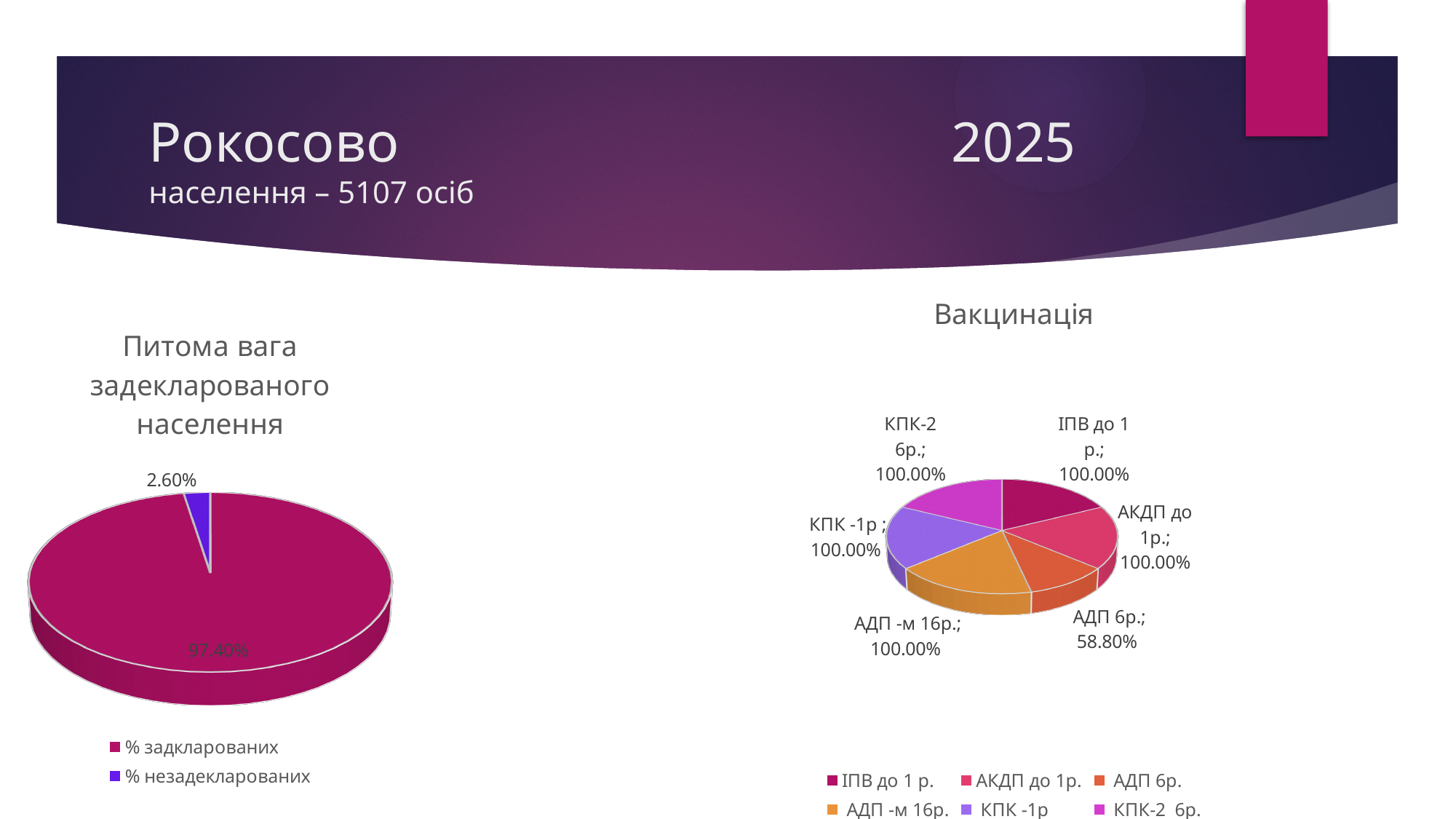
On the left chart 'Питома вага задекларованого населення', how many series does the legend list? 2 On the left chart 'Питома вага задекларованого населення', what is the difference between the two slices? 94.80% On the 'Вакцинація' chart, which category has the lowest value? АДП 6р. On the left chart 'Питома вага задекларованого населення', which category has the larger share? % задклaрованих On the 'Вакцинація' chart, what is the difference between the values for 'ІПВ до 1 р.' and 'АДП 6р.'? 41.20% On the 'Вакцинація' chart, which is larger: the value for 'АДП -м 16р.' or the value for 'АДП 6р.'? АДП -м 16р. What kind of chart is the 'Вакцинація' chart? Pie chart On the left chart 'Питома вага задекларованого населення', what is the value for '% незадекларованих'? 2.60% On the 'Вакцинація' chart, what is the value for 'АДП 6р.'? 58.80% On the left chart 'Питома вага задекларованого населення', what is the value for '% задклaрованих'? 97.40% On the 'Вакцинація' chart, how many categories are shown? 6 On the 'Вакцинація' chart, what is the value for 'КПК -1р'? 100.00%